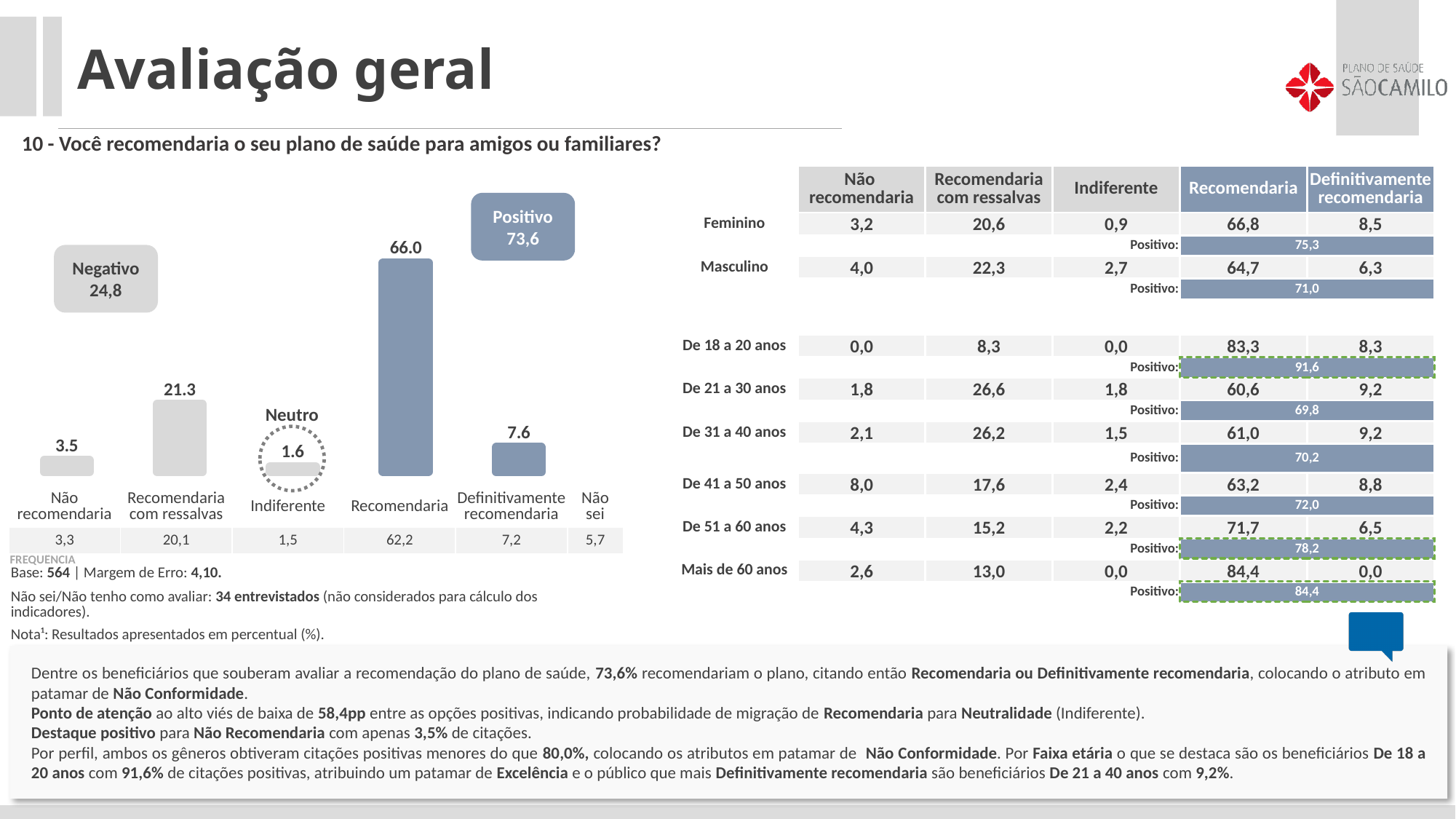
What is the difference between the 'Recomendaria' bar and the 'Recomendaria com ressalvas' bar? 44.7 Which category has the highest bar in the chart? Recomendaria What value is shown in the 'Positivo' box above the chart? 73,6 What type of chart is shown on the left of the slide? Bar chart What is the value shown for the 'Recomendaria com ressalvas' bar? 21.3 What is the value shown for the 'Recomendaria' bar in the chart? 66.0 What value is shown in the 'Negativo' box in the chart? 24,8 What is the value shown for the 'Não recomendaria' bar in the chart? 3.5 Which is larger: the 'Definitivamente recomendaria' bar or the 'Não recomendaria' bar? Definitivamente recomendaria How many bars are plotted in the chart? 5 What is the value shown for the 'Definitivamente recomendaria' bar? 7.6 Which category has the lowest bar in the chart? Indiferente